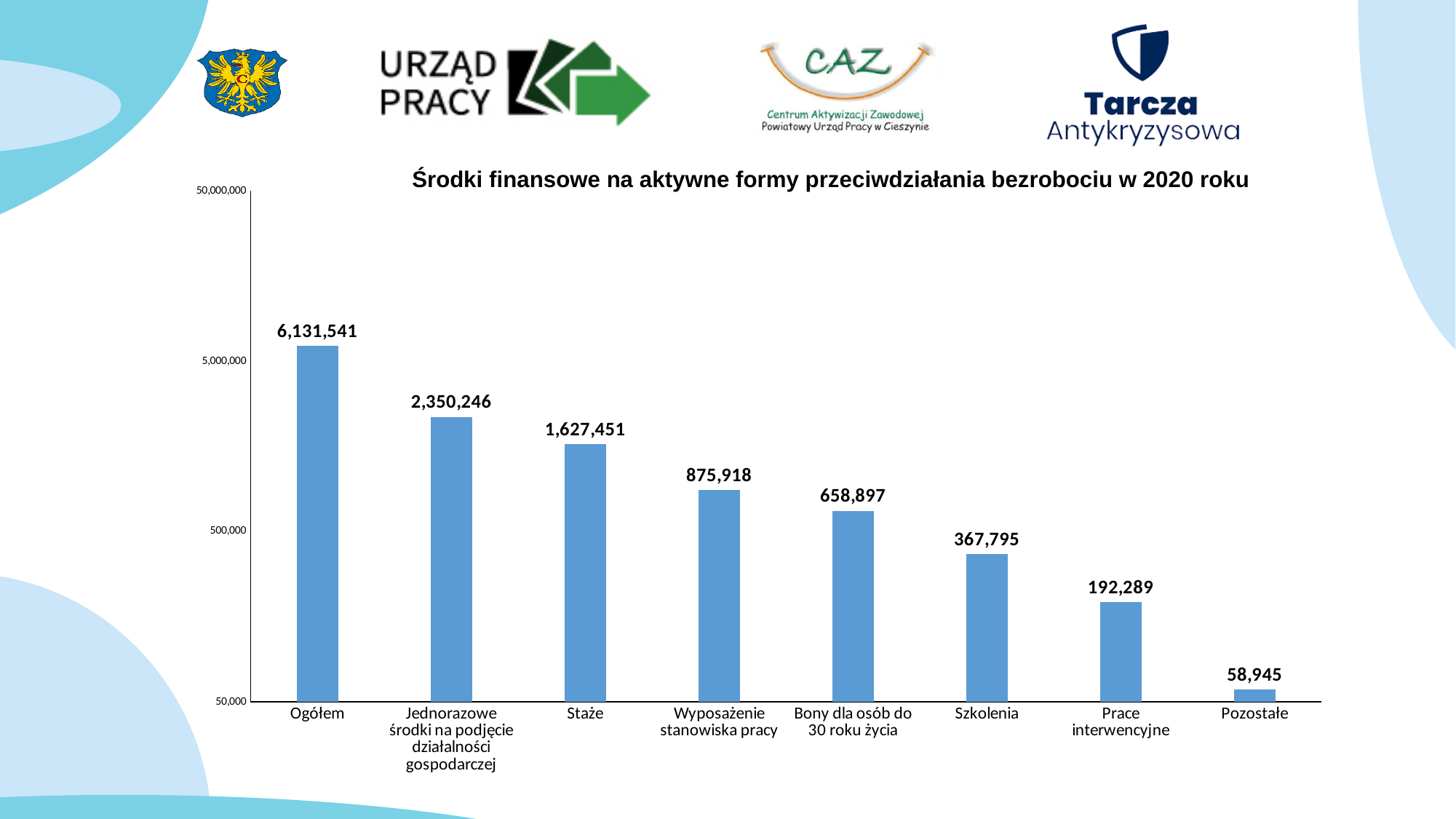
What is the value for Szkolenia? 367,795 What is the value for Pozostałe? 58,945 What kind of chart is shown on the slide? Bar chart What is the difference between the values for Szkolenia and Prace interwencyjne? 175,506 What is the value for Staże? 1,627,451 How many categories are shown on the x axis? 8 Which is larger, the value for Wyposażenie stanowiska pracy or the value for Bony dla osób do 30 roku życia? Wyposażenie stanowiska pracy Which category has the lowest value? Pozostałe Which category has the highest value? Ogółem What is the difference between the values for Staże and Wyposażenie stanowiska pracy? 751,533 Do the values rise or fall from left to right along the x axis? Fall What is the value for Bony dla osób do 30 roku życia? 658,897